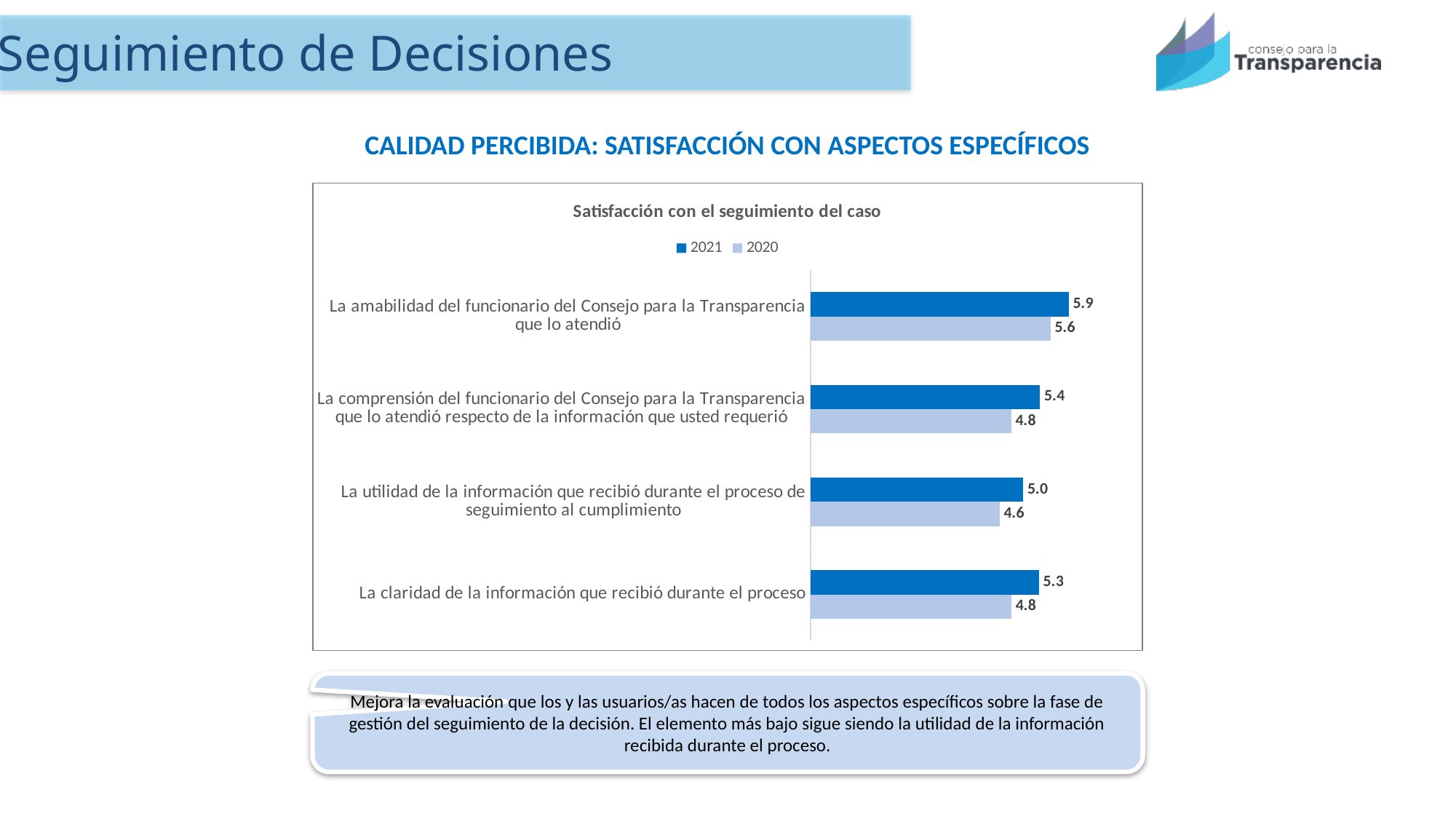
What is the 2020 value for 'La utilidad de la información que recibió durante el proceso de seguimiento al cumplimiento'? 4.6 What is the 2021 value for 'La amabilidad del funcionario del Consejo para la Transparencia que lo atendió'? 5.9 What is the title of the chart? Satisfacción con el seguimiento del caso Which category has the lowest 2020 value? La utilidad de la información que recibió durante el proceso de seguimiento al cumplimiento Which series is shown in dark blue in the legend? 2021 What kind of chart is shown on the slide? Bar chart Which is larger for 'La claridad de la información que recibió durante el proceso': the 2021 value or the 2020 value? 2021 What is the 2021 value for 'La claridad de la información que recibió durante el proceso'? 5.3 How many categories are shown in the chart? 4 What is the difference between the 2021 and 2020 values for 'La comprensión del funcionario del Consejo para la Transparencia que lo atendió respecto de la información que usted requerió'? 0.6 How many series does the legend list? 2 Which category has the highest 2021 value? La amabilidad del funcionario del Consejo para la Transparencia que lo atendió